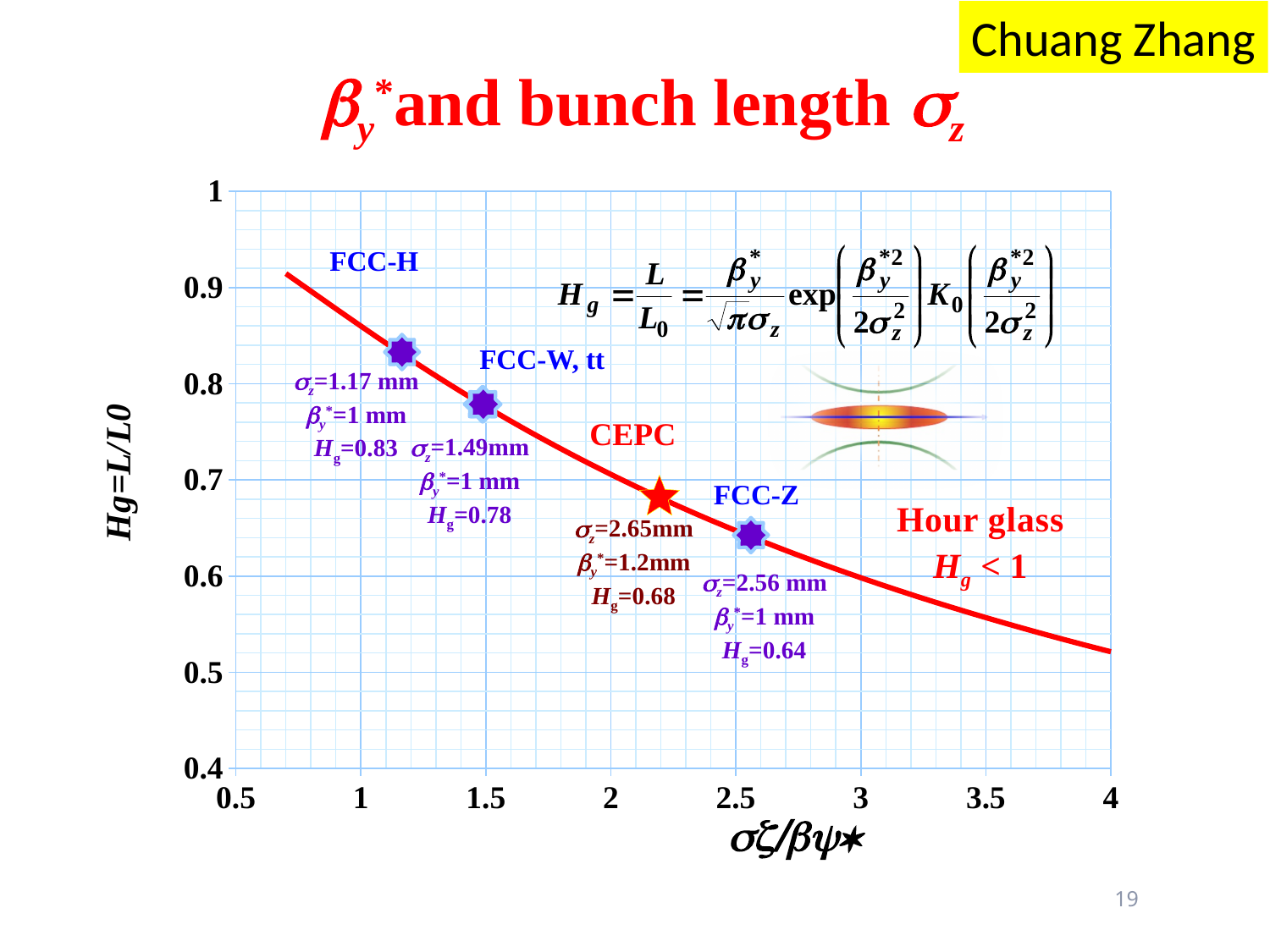
What kind of chart is shown on the slide? line chart How many labelled points are marked on the curve? 4 What bunch length σz is labelled for the CEPC point? 2.65mm What is the Hg value labelled for the FCC-Z point? 0.64 Which has a larger Hg value, CEPC or FCC-Z? CEPC What is the Hg value labelled for the FCC-W, tt point? 0.78 Which labelled point has the highest Hg value? FCC-H What is the difference between the Hg values of FCC-H and FCC-Z? 0.19 What is the Hg value labelled for the FCC-H point? 0.83 Which labelled point has the lowest Hg value? FCC-Z Does the red curve rise or fall as σz/βy* increases along the x axis? fall What is the Hg value labelled for the CEPC point? 0.68